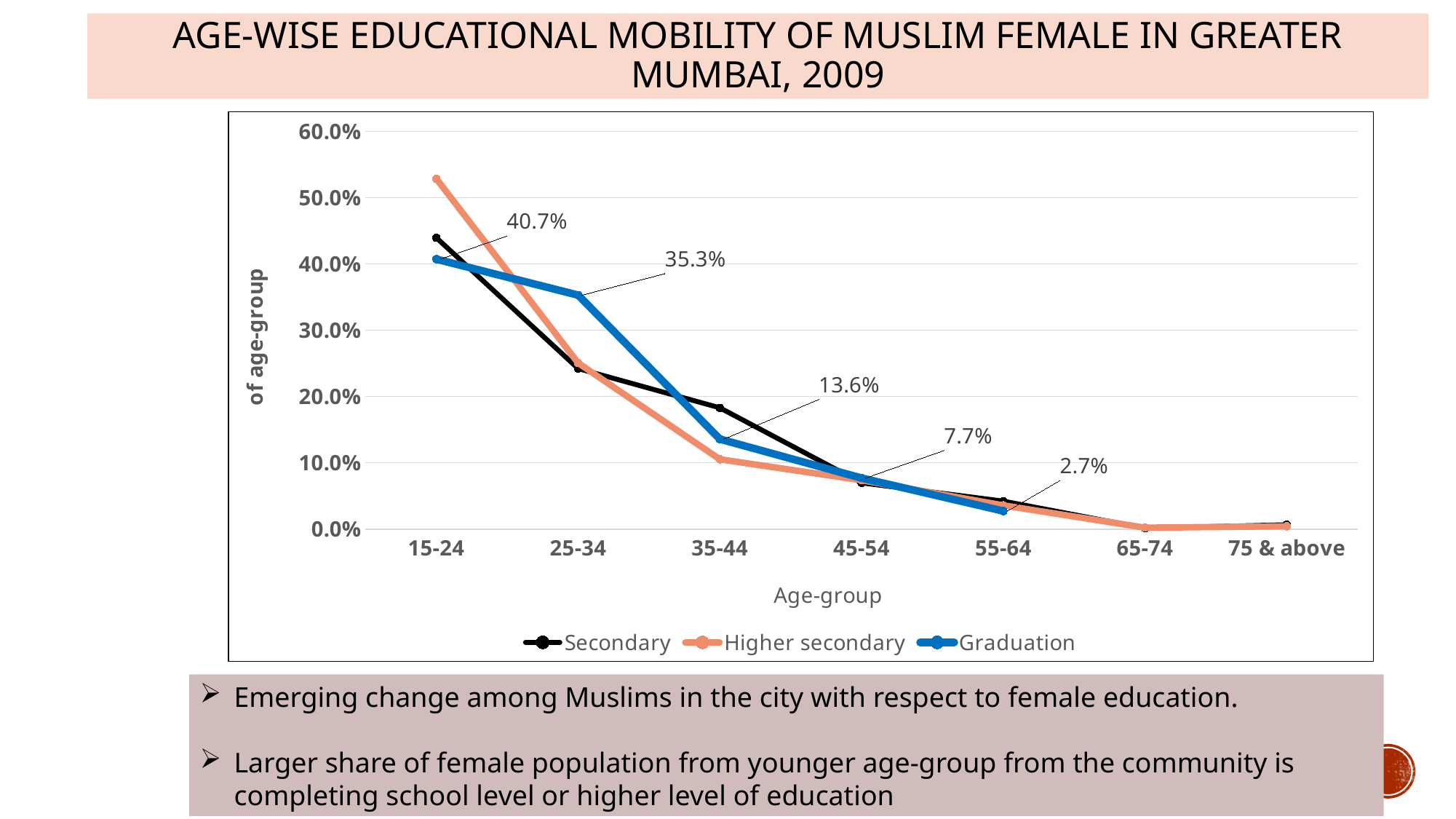
Is the Higher secondary value for the 15-24 age group greater or less than 50.0%? greater Which age group has the highest Graduation value? 15-24 What is the difference between the Graduation values for the 15-24 and 25-34 age groups? 5.4 percentage points How many age groups are shown on the x axis? 7 What kind of chart is shown on the slide? Line chart What is the Graduation value for the 25-34 age group? 35.3% What is the Graduation value for the 55-64 age group? 2.7% How many series does the legend list? 3 At the 25-34 age group, which is larger: the Graduation value or the Secondary value? Graduation Which age group has the lowest Graduation value? 55-64 What is the Graduation value for the 35-44 age group? 13.6% What is the Graduation value for the 15-24 age group? 40.7%